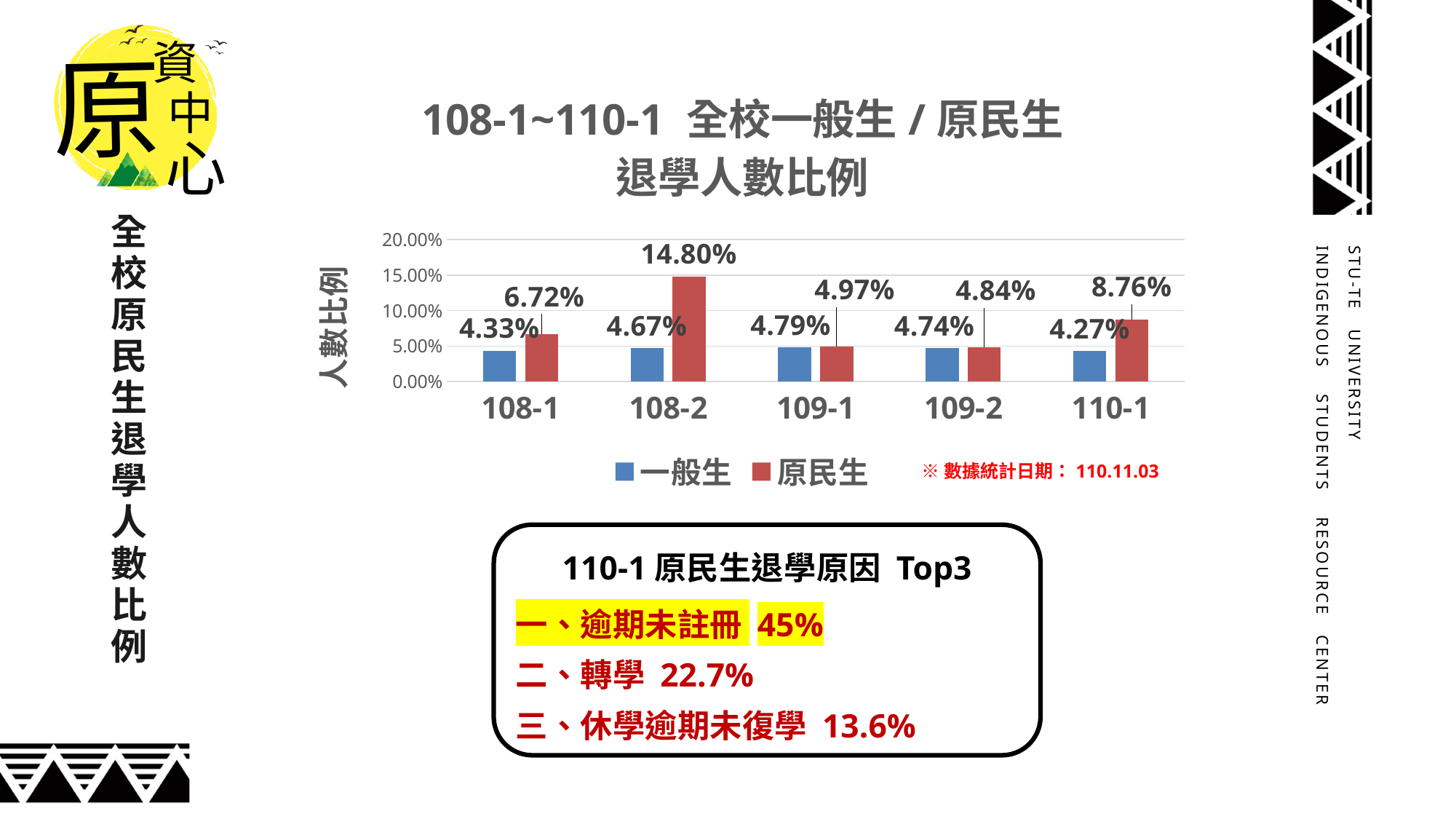
What is the value for 原民生 in 109-2? 4.84% What is the value for 原民生 in 108-2? 14.80% In which semester is the 一般生 value lowest? 110-1 What is the difference between the 原民生 and 一般生 values in 110-1? 4.49% How many series does the legend list? 2 Which colour represents 原民生 in the chart? red What is the value for 一般生 in 110-1? 4.27% What kind of chart is shown on the slide? bar chart How many semesters are shown on the x axis? 5 Is the value for 原民生 in 108-2 greater or less than 10.00%? greater Which is larger in 108-1, the 一般生 value or the 原民生 value? 原民生 In which semester is the 原民生 value highest? 108-2